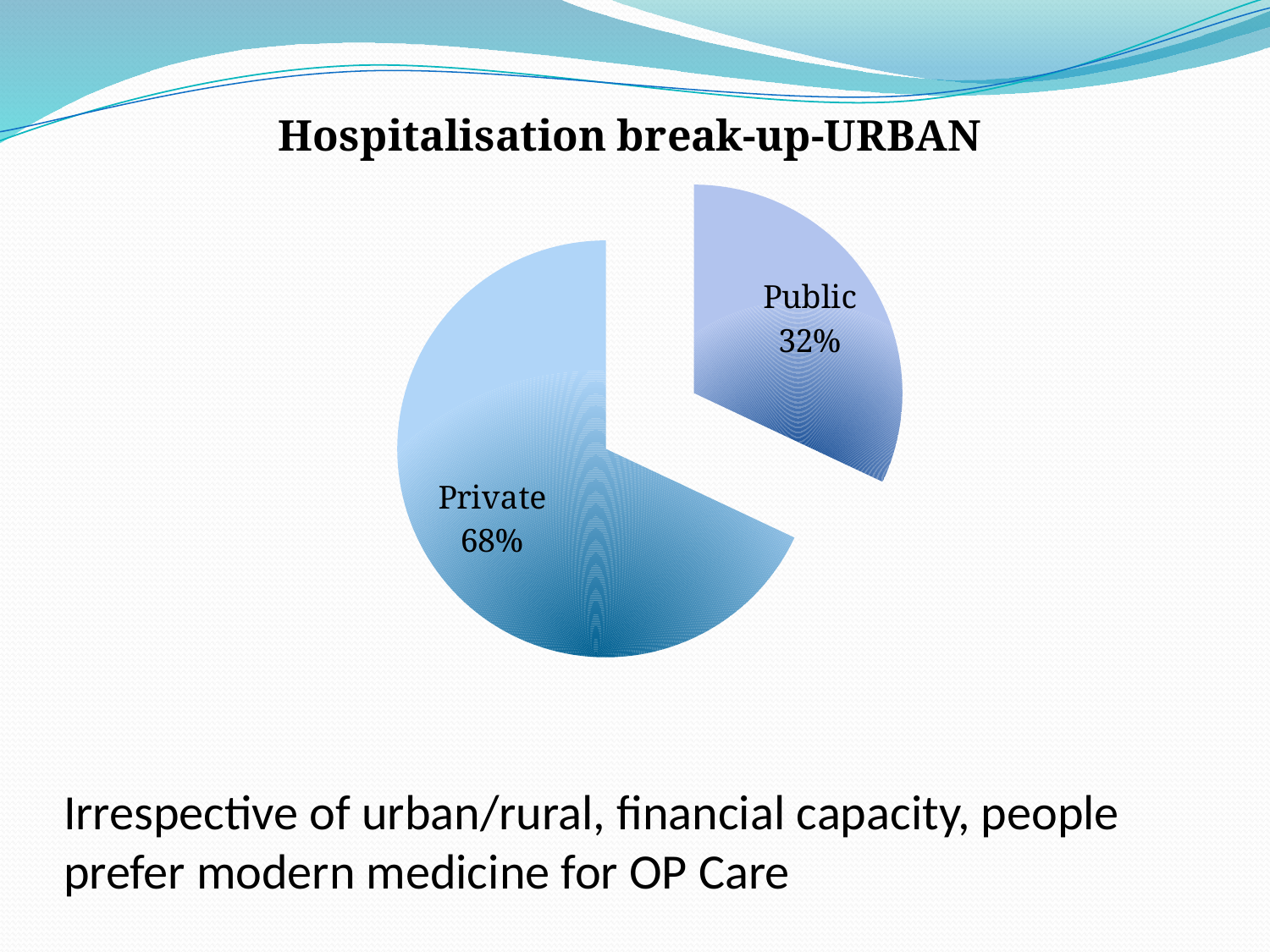
Which is larger, the Private slice or the Public slice? Private Is the value for Private greater or less than 50%? greater What type of chart is shown on the slide? pie chart Is the value for Public greater or less than 50%? less What share of the pie does Private account for? 68% What share of the pie does Public account for? 32% Which slice is the largest in the pie chart? Private Which slice is the smallest in the pie chart? Public What is the title of the chart? Hospitalisation break-up-URBAN What is the difference in percentage points between the Private and Public slices? 36 How many slices does the pie chart have? 2